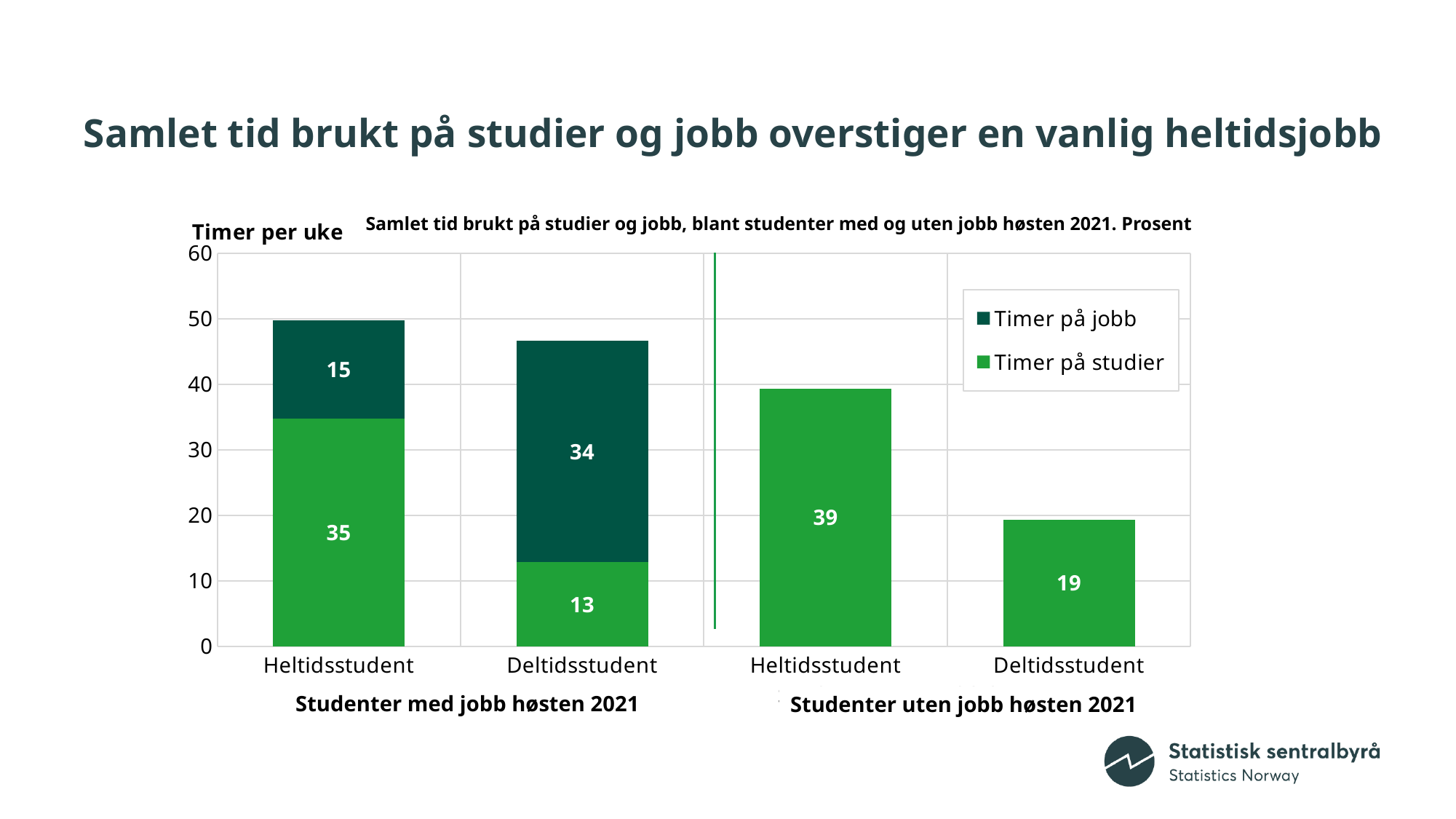
Which bar has the lowest total hours per week? Deltidsstudent (Studenter uten jobb høsten 2021) Which is larger: hours on work for Heltidsstudent or for Deltidsstudent among students with a job (Studenter med jobb høsten 2021)? Deltidsstudent How many hours per week on work (Timer på jobb) are shown for Deltidsstudent among students with a job (Studenter med jobb høsten 2021)? 34 What is the difference in hours on studies between Heltidsstudent and Deltidsstudent among students without a job (Studenter uten jobb høsten 2021)? 20 How many hours per week on studies are shown for Heltidsstudent among students without a job (Studenter uten jobb høsten 2021)? 39 What is the label of the vertical axis? Timer per uke How many bars are plotted in the chart? 4 What is the total height of the stacked bar for Heltidsstudent among students with a job (Studenter med jobb høsten 2021)? 50 What is the total height of the stacked bar for Deltidsstudent among students with a job (Studenter med jobb høsten 2021)? 47 How many hours per week on studies (Timer på studier) are shown for Heltidsstudent among students with a job (Studenter med jobb høsten 2021)? 35 What kind of chart is shown on the slide? Stacked bar chart How many series does the legend list? 2